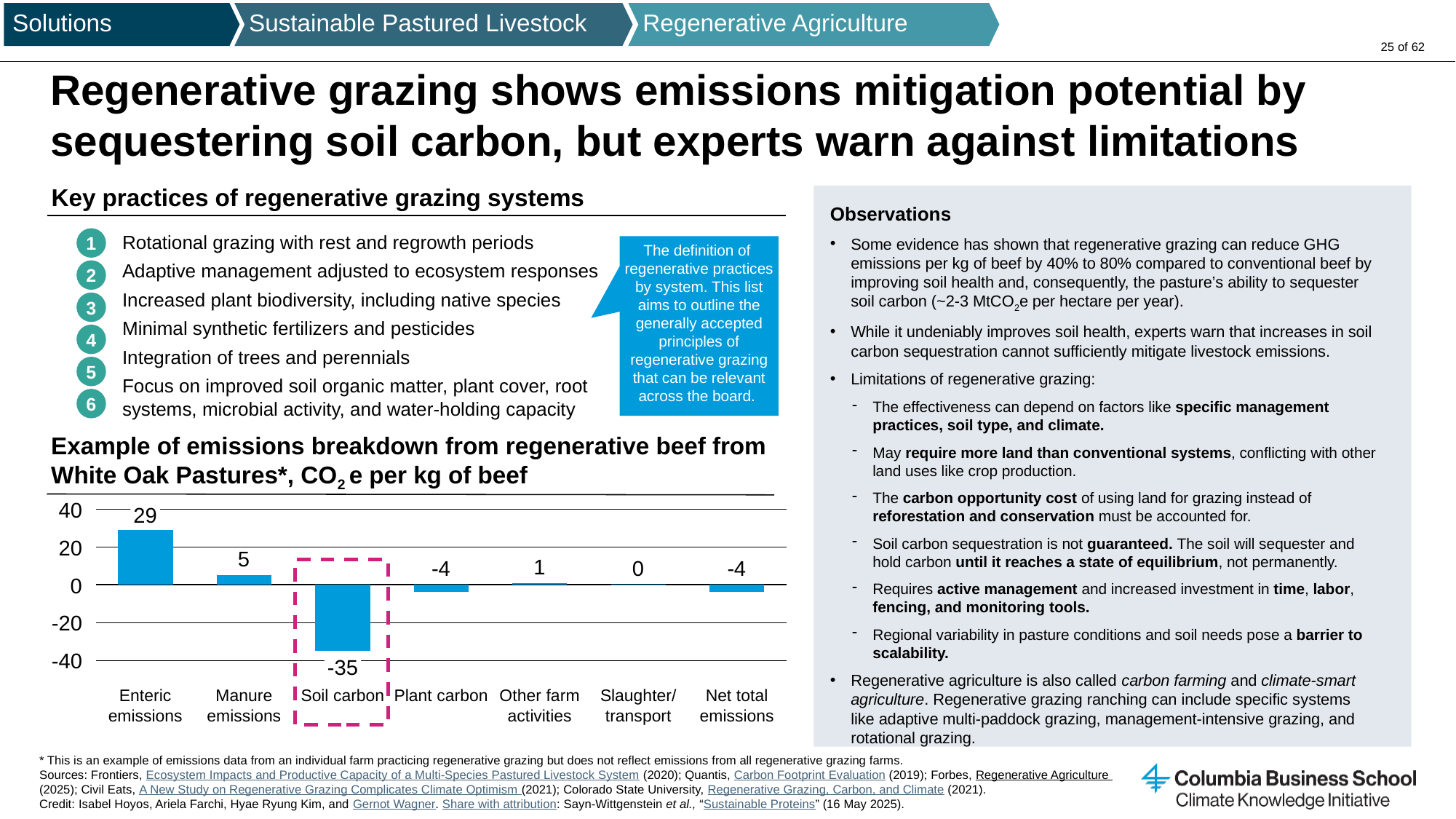
What is the value for Net total emissions in the emissions breakdown chart? -4 What is the value for Enteric emissions in the emissions breakdown chart? 29 What is the value for Soil carbon in the emissions breakdown chart? -35 What is the value for Slaughter/transport in the emissions breakdown chart? 0 How many categories are shown on the x axis of the emissions breakdown chart? 7 What kind of chart is used for the emissions breakdown from regenerative beef? Bar chart What is the difference between Enteric emissions and Manure emissions in the emissions breakdown chart? 24 Which category has the highest value in the emissions breakdown chart? Enteric emissions Which category in the emissions breakdown chart is highlighted with a dashed outline? Soil carbon Which is larger in the emissions breakdown chart, Manure emissions or Other farm activities? Manure emissions Which category has the lowest value in the emissions breakdown chart? Soil carbon What is the value for Manure emissions in the emissions breakdown chart? 5